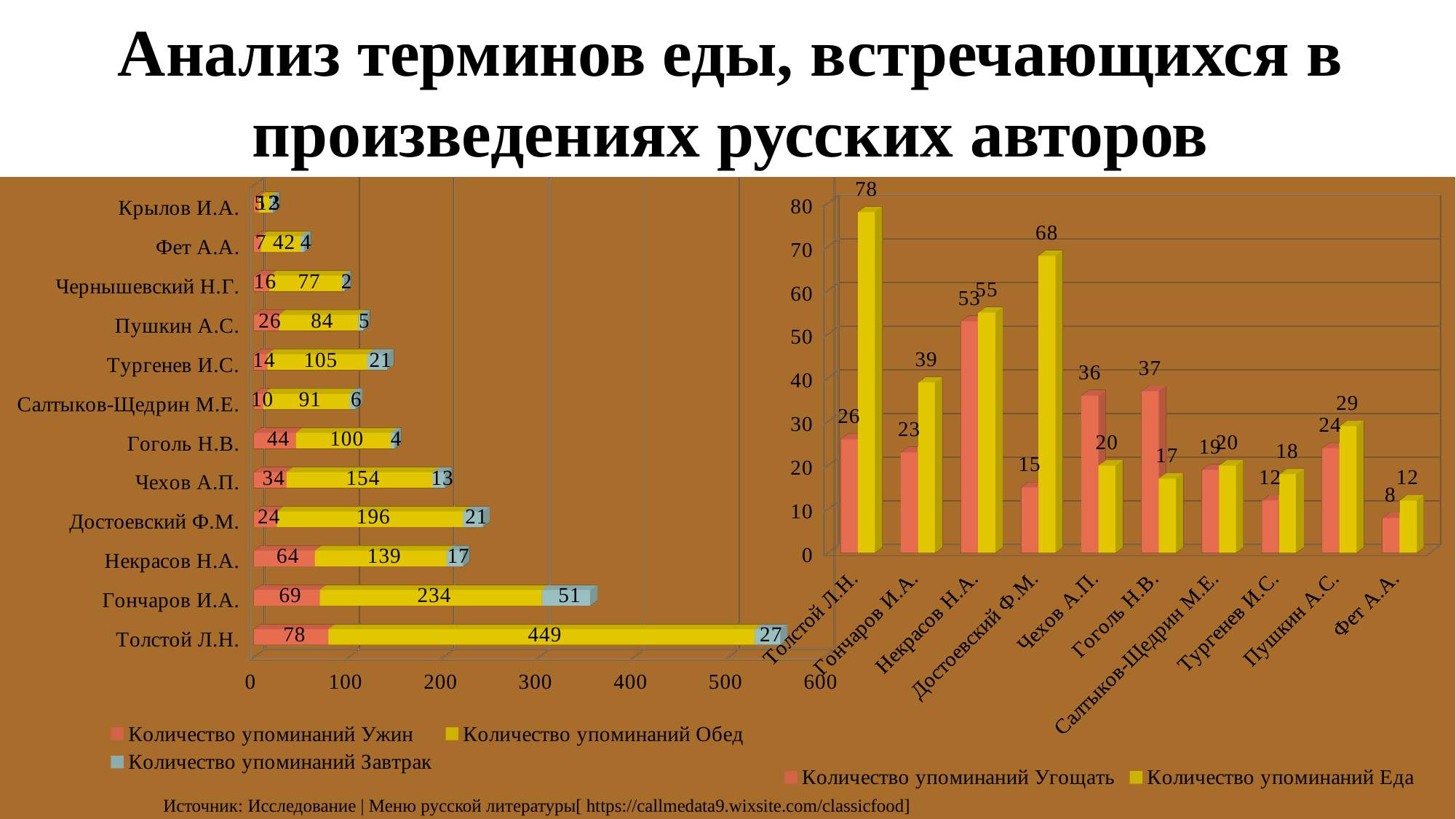
In the left chart, how many mentions of Обед are there for Толстой Л.Н.? 449 In the left chart, what is the difference between the Обед mentions for Достоевский Ф.М. and Некрасов Н.А.? 57 In the right chart, which is larger for Гоголь Н.В.: mentions of Угощать or mentions of Еда? Угощать In the left chart, what is the total of the stacked bar for Чехов А.П.? 201 In the right chart, how many mentions of Еда are there for Достоевский Ф.М.? 68 In the right chart, which author has the lowest number of mentions of Угощать? Фет А.А. In the left chart, how many mentions of Завтрак are there for Гончаров И.А.? 51 How many series does the legend of the left chart list? 3 What type of chart is the right chart? Bar chart How many authors are shown on the x axis of the right chart? 10 In the left chart, which author has the highest number of mentions of Ужин? Толстой Л.Н. In the right chart, what is the difference between the Еда mentions for Толстой Л.Н. and Гончаров И.А.? 39